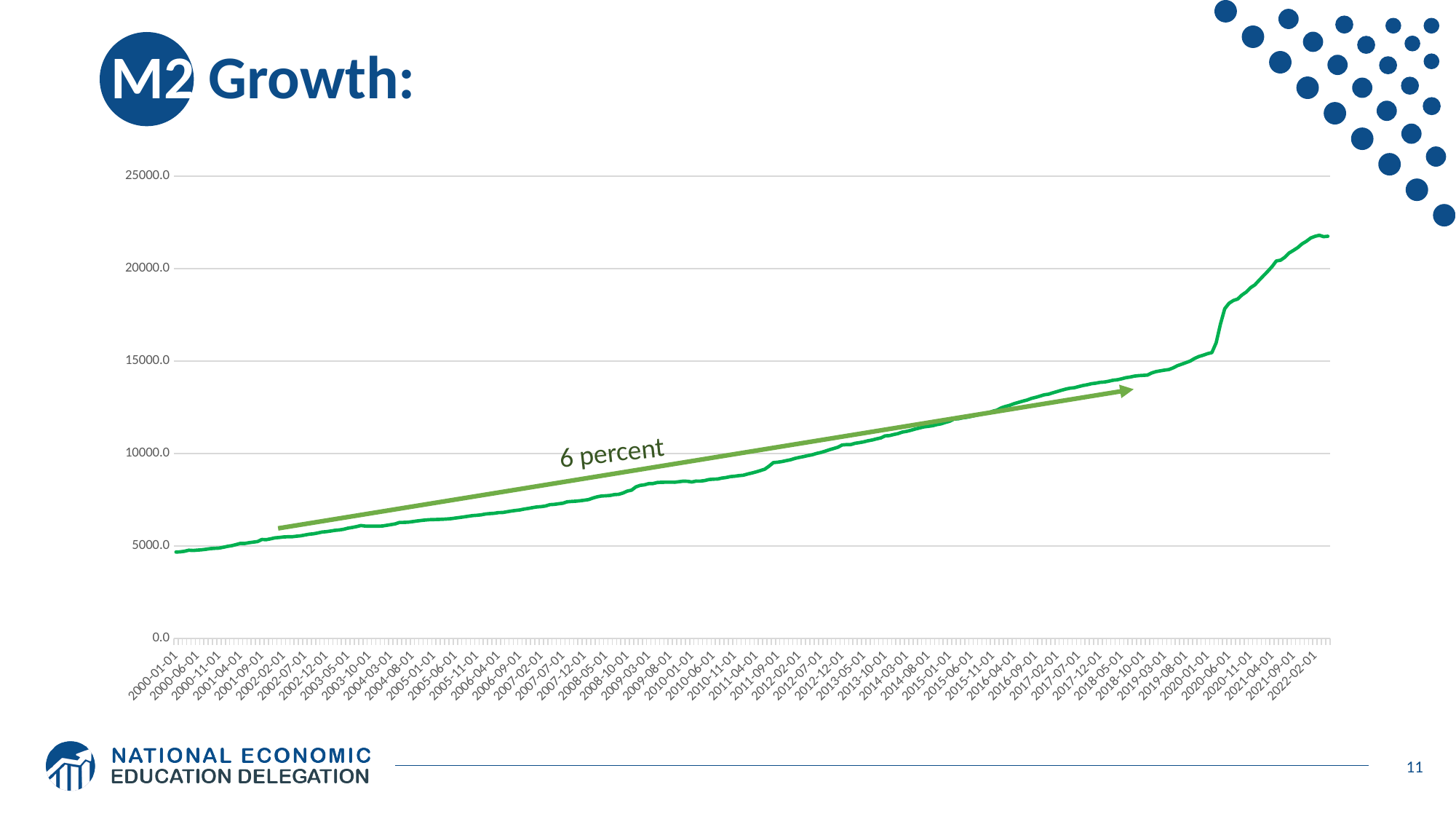
What kind of chart is shown on the slide? line chart Is the value at 2010-01-01 greater or less than 10000.0? less Is the value at 2016-04-01 greater or less than 10000.0? greater What is the highest value shown on the y axis? 25000.0 Is the value at 2000-01-01 greater or less than 5000.0? less Which is larger, the value at 2022-02-01 or the value at 2000-01-01? 2022-02-01 At which end of the x axis does the line reach its lowest value? 2000-01-01 What growth rate does the annotation along the straight arrow state? 6 percent Do the values on the chart generally rise or fall from 2000-01-01 to 2022-02-01? rise